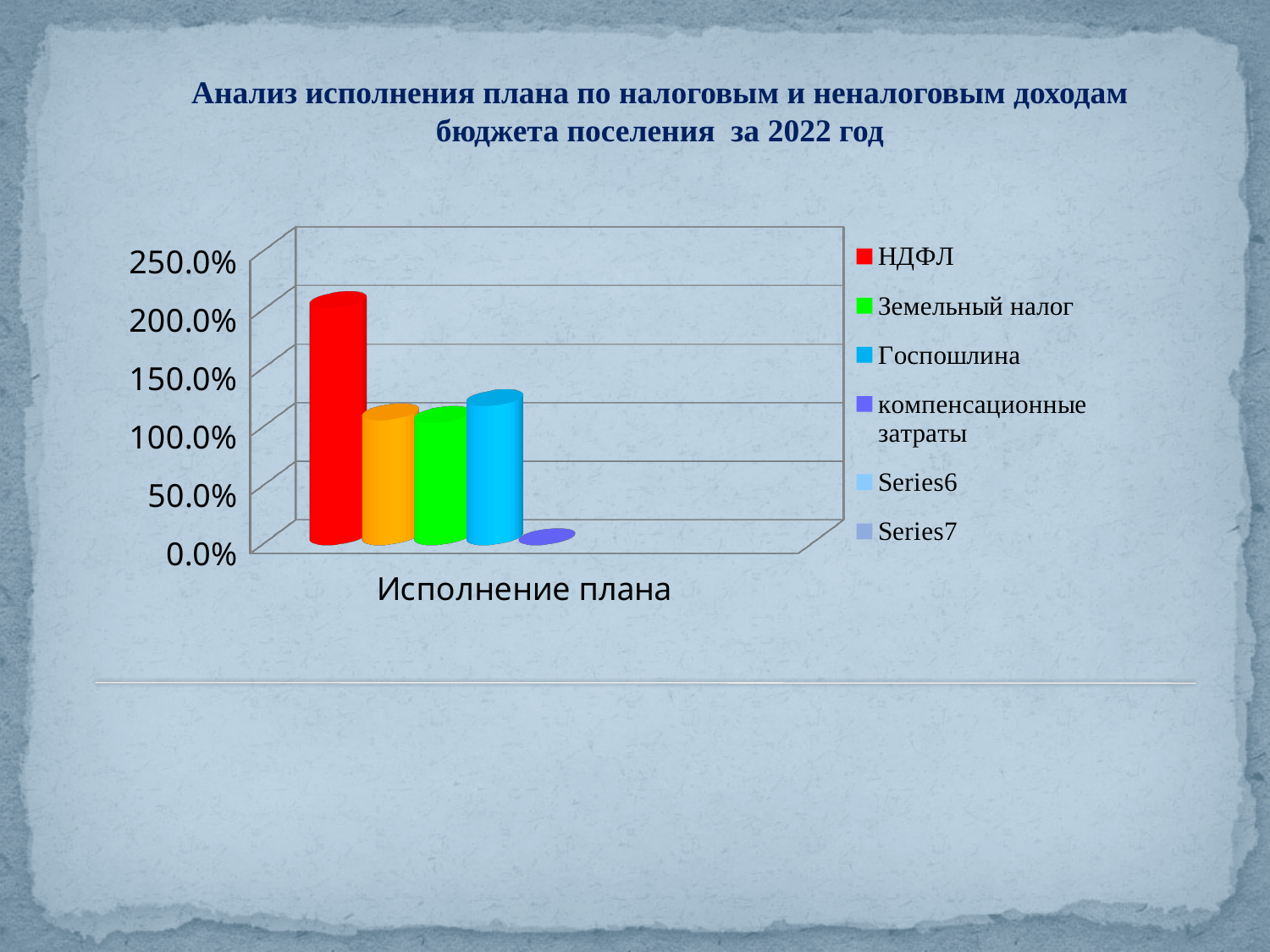
What colour is used for the НДФЛ series in the legend? red How many categories are shown on the x axis? 1 Which is larger, the value for НДФЛ or the value for Госпошлина? НДФЛ Which series has the highest value? НДФЛ How many series does the legend list? 6 Is the value for компенсационные затраты greater or less than 50.0%? less Which is larger, the value for Госпошлина or the value for компенсационные затраты? Госпошлина Is the value for Земельный налог greater or less than 150.0%? less What is the category label on the x axis? Исполнение плана What kind of chart is shown on the slide? bar chart Which series has the lowest value? компенсационные затраты Is the value for НДФЛ greater or less than 150.0%? greater